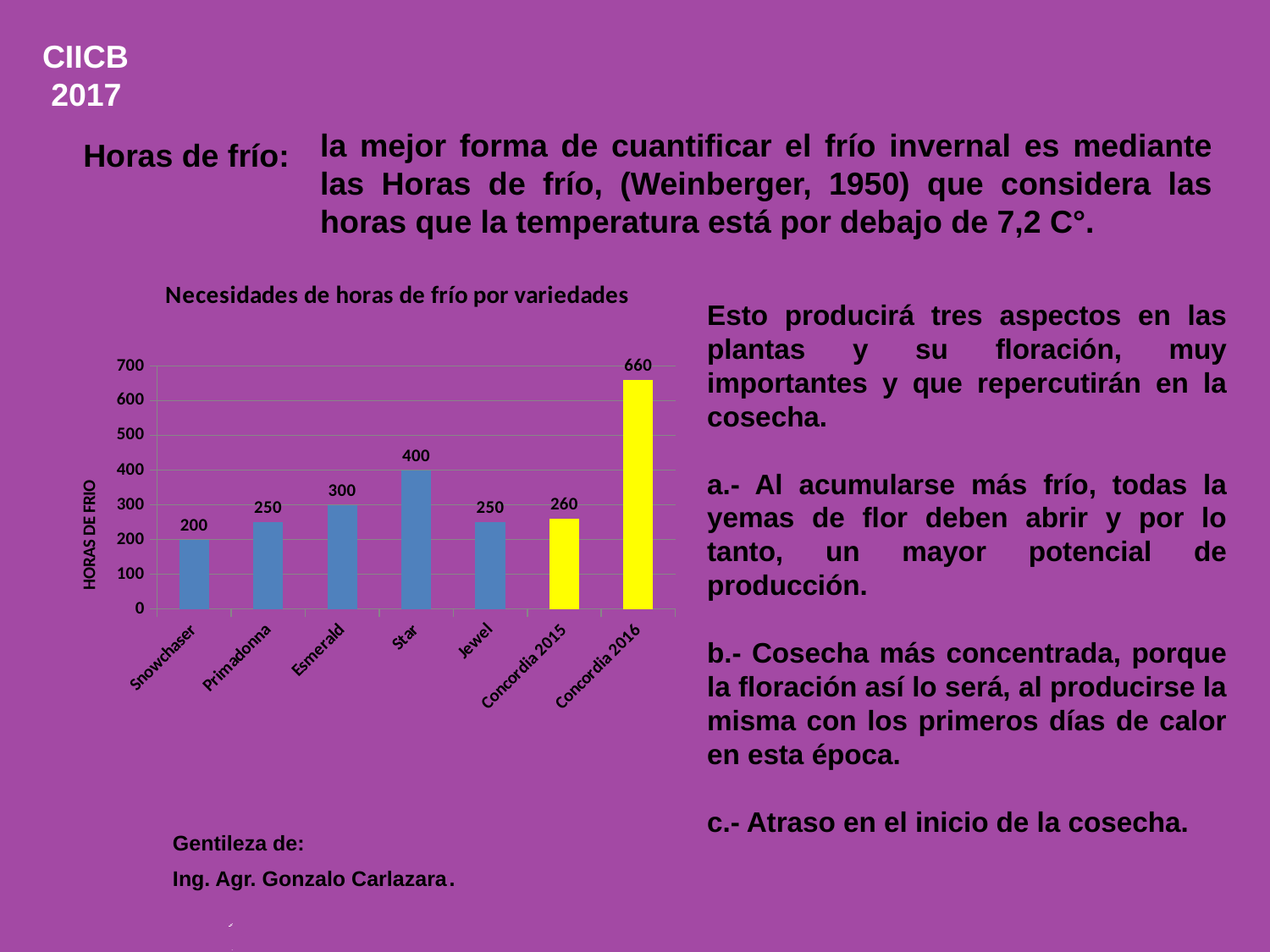
What kind of chart is shown on the slide? Bar chart Which category has the lowest value? Snowchaser Which category has the highest value? Concordia 2016 What is the title of the chart? Necesidades de horas de frío por variedades What is the difference between Star and Esmerald? 100 Which is larger, the value for Esmerald or the value for Jewel? Esmerald What is the value for Star in the chart? 400 What is the value for Concordia 2015? 260 What is the value for Snowchaser? 200 What is the difference between Concordia 2016 and Concordia 2015? 400 How many categories are shown on the x axis? 7 What is the value for Concordia 2016? 660